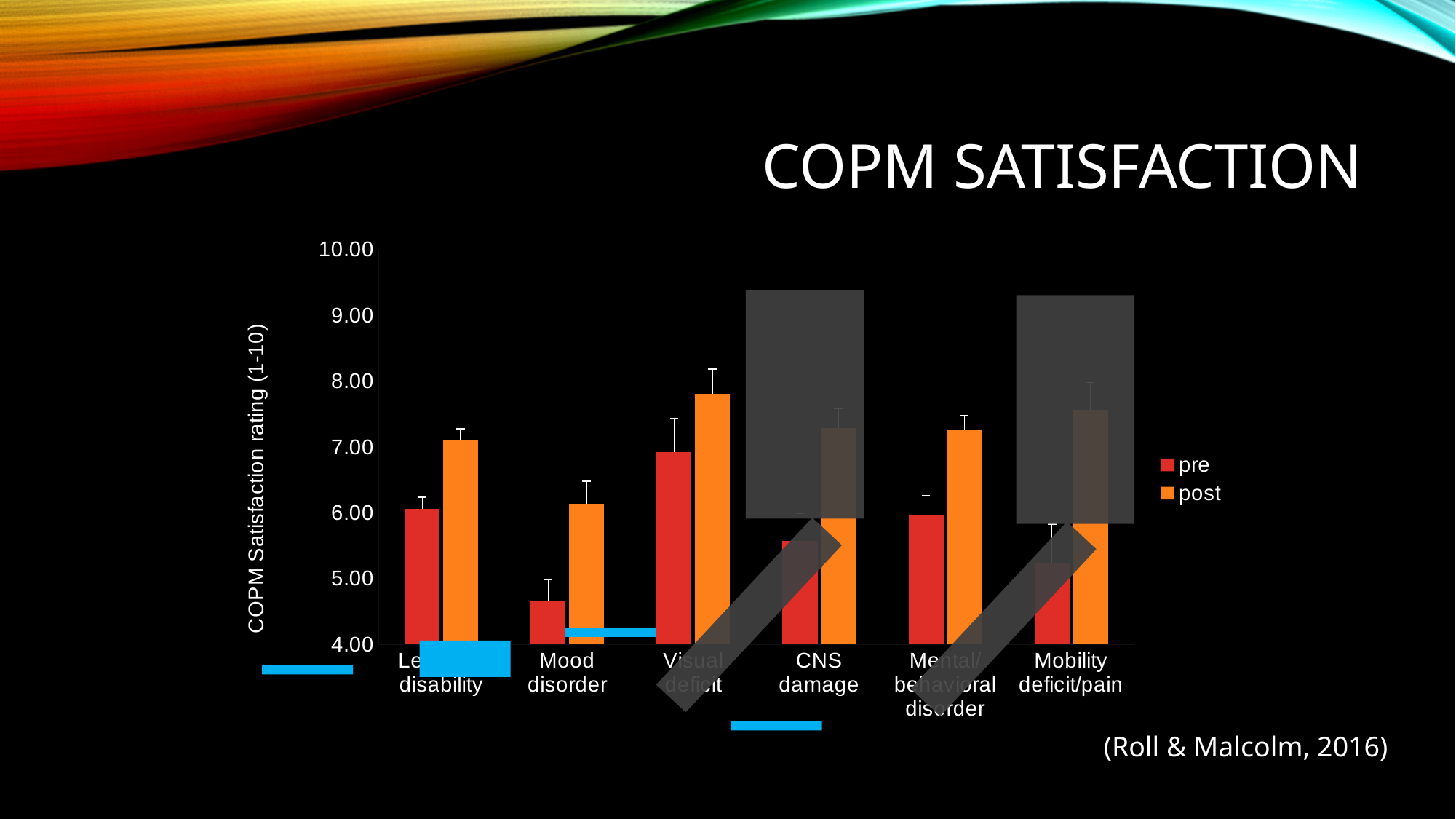
Which is larger for Mood disorder, the pre value or the post value? post Is the post value for Mental/behavioral disorder greater or less than 6.00? greater Which category has the lowest pre value? Mood disorder Is the pre value for Visual deficit greater or less than 6.00? greater What are the two series named in the legend? pre and post What is the y-axis title of the chart? COPM Satisfaction rating (1-10) How many categories are shown on the x axis? 6 Is the post value for Visual deficit greater or less than 7.00? greater What kind of chart is shown on the slide? bar chart How many series does the legend list? 2